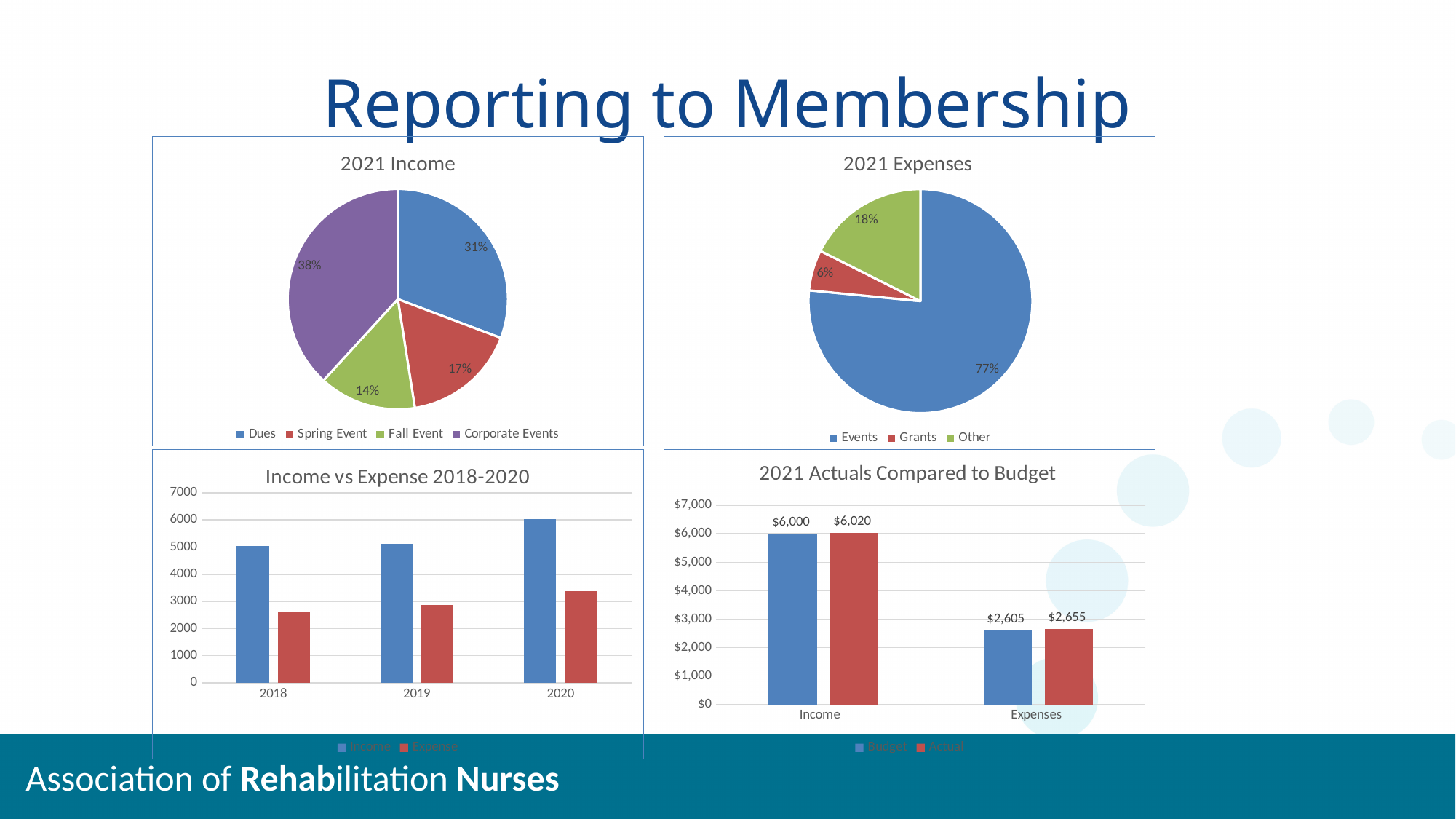
In the Income vs Expense 2018-2020 chart, is the Income value for 2020 greater or less than 5000? greater In the 2021 Actuals Compared to Budget chart, what is the Actual value for Expenses? $2,655 In the 2021 Expenses pie chart, which category has the smallest share? Grants In the Income vs Expense 2018-2020 chart, what kind of chart is it? bar chart In the 2021 Income pie chart, which category has the smallest share? Fall Event In the 2021 Actuals Compared to Budget chart, how many series does the legend list? 2 In the 2021 Income pie chart, what share does Corporate Events have? 38% In the 2021 Expenses pie chart, how many categories does the legend list? 3 In the 2021 Actuals Compared to Budget chart, what is the difference between the Actual and Budget values for Income? $20 In the 2021 Income pie chart, what is the share for Dues? 31% In the Income vs Expense 2018-2020 chart, does Expense rise or fall from 2018 to 2020? rise In the 2021 Expenses pie chart, what share does Events have? 77%